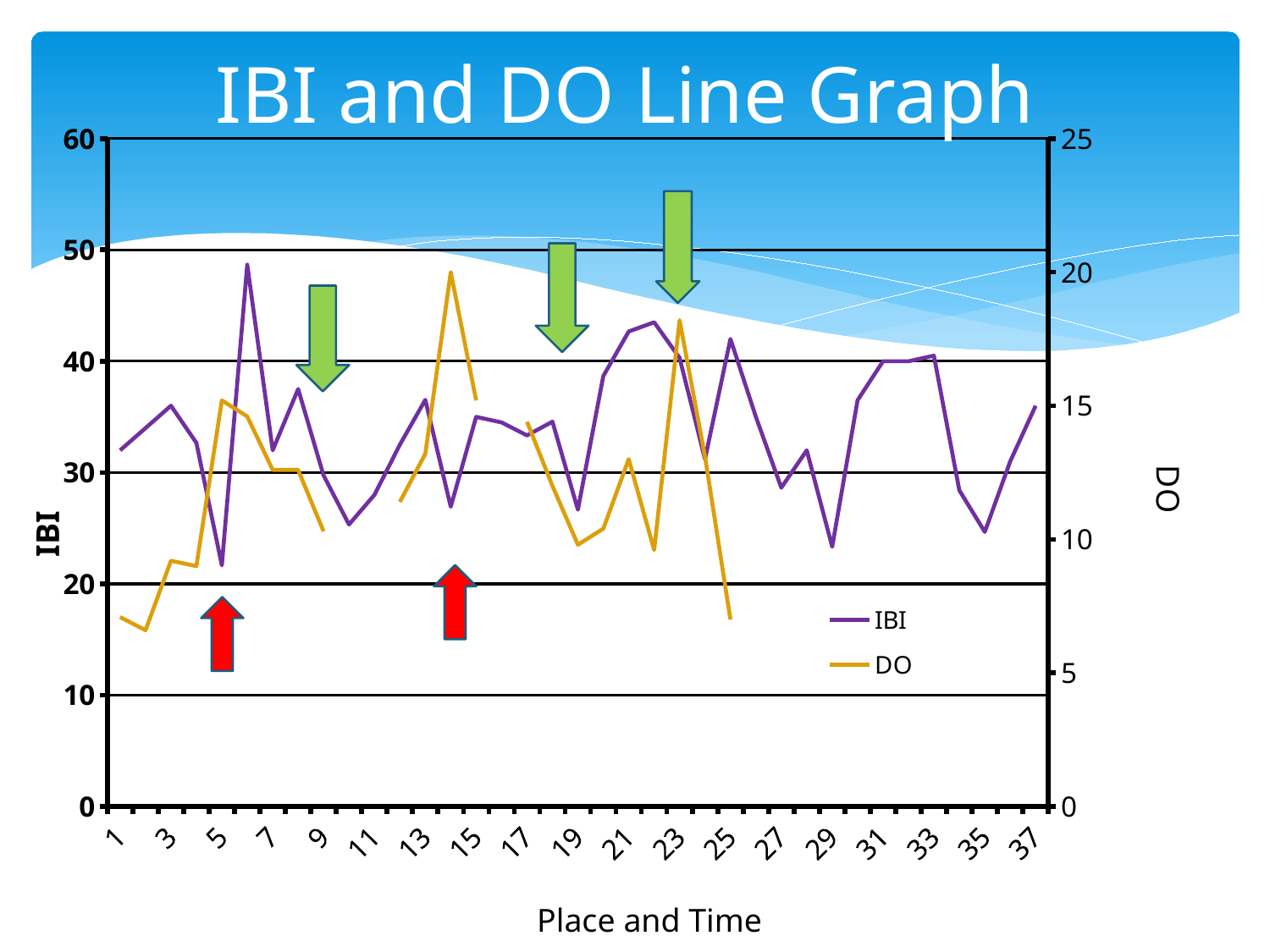
What is the title of the chart? IBI and DO Line Graph Is the IBI value at position 29 greater or less than 30? less How many series does the legend list? 2 Is the DO value at position 25 greater or less than 10? less What is the label of the horizontal axis? Place and Time At which x-axis position does the DO series reach its highest value? 14 At which x-axis position does the IBI series reach its highest value? 6 Is the IBI value at position 6 greater or less than 40? greater What kind of chart is shown on the slide? line chart Which is larger, the IBI value at position 6 or the IBI value at position 29? position 6